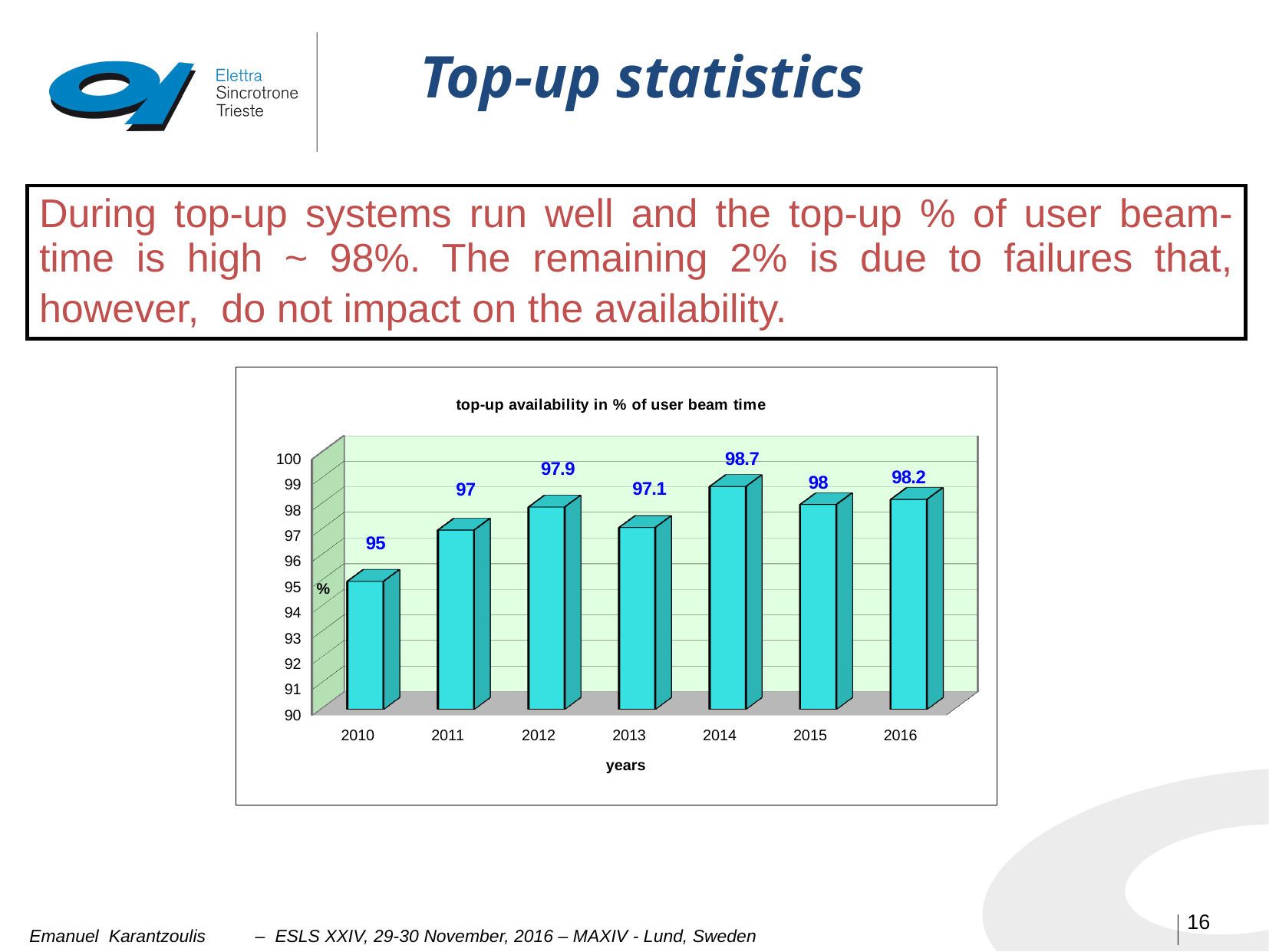
What is the difference between the top-up availability in 2014 and in 2010? 3.7 Which year has a higher top-up availability, 2012 or 2013? 2012 What kind of chart is shown on the slide? bar chart What is the top-up availability value for 2014? 98.7 Which year has the highest top-up availability? 2014 Is the value for 2011 greater or less than 96? greater What is the top-up availability value for 2010? 95 What is the label of the x axis of the chart? years How many years are shown on the x axis of the chart? 7 What is the top-up availability value for 2016? 98.2 What is the title of the chart? top-up availability in % of user beam time Which year has the lowest top-up availability? 2010